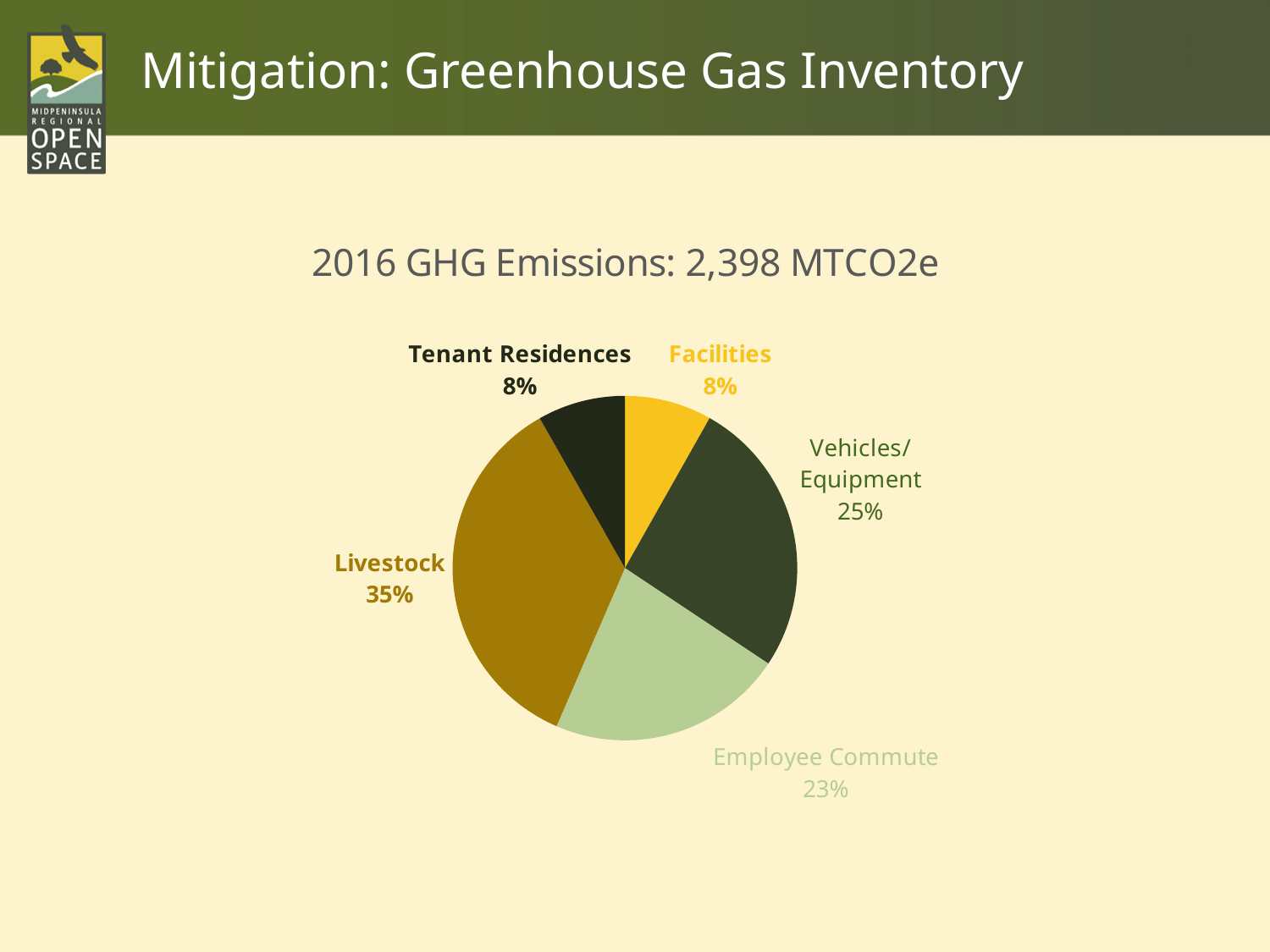
What is the total 2016 GHG emissions figure stated above the chart? 2,398 MTCO2e Which is larger, the share for Vehicles/Equipment or the share for Employee Commute? Vehicles/Equipment Which two categories have the same share of emissions? Tenant Residences and Facilities What share of 2016 GHG emissions comes from Employee Commute? 23% What is the difference in percentage points between the Vehicles/Equipment and Tenant Residences shares? 17 What share of 2016 GHG emissions comes from Vehicles/Equipment? 25% Which category accounts for the largest share of 2016 GHG emissions? Livestock How many categories are shown in the pie chart? 5 What share of 2016 GHG emissions comes from Facilities? 8% What kind of chart is shown on the slide? Pie chart What share of 2016 GHG emissions comes from Livestock? 35% What is the difference in percentage points between the Livestock and Employee Commute shares? 12